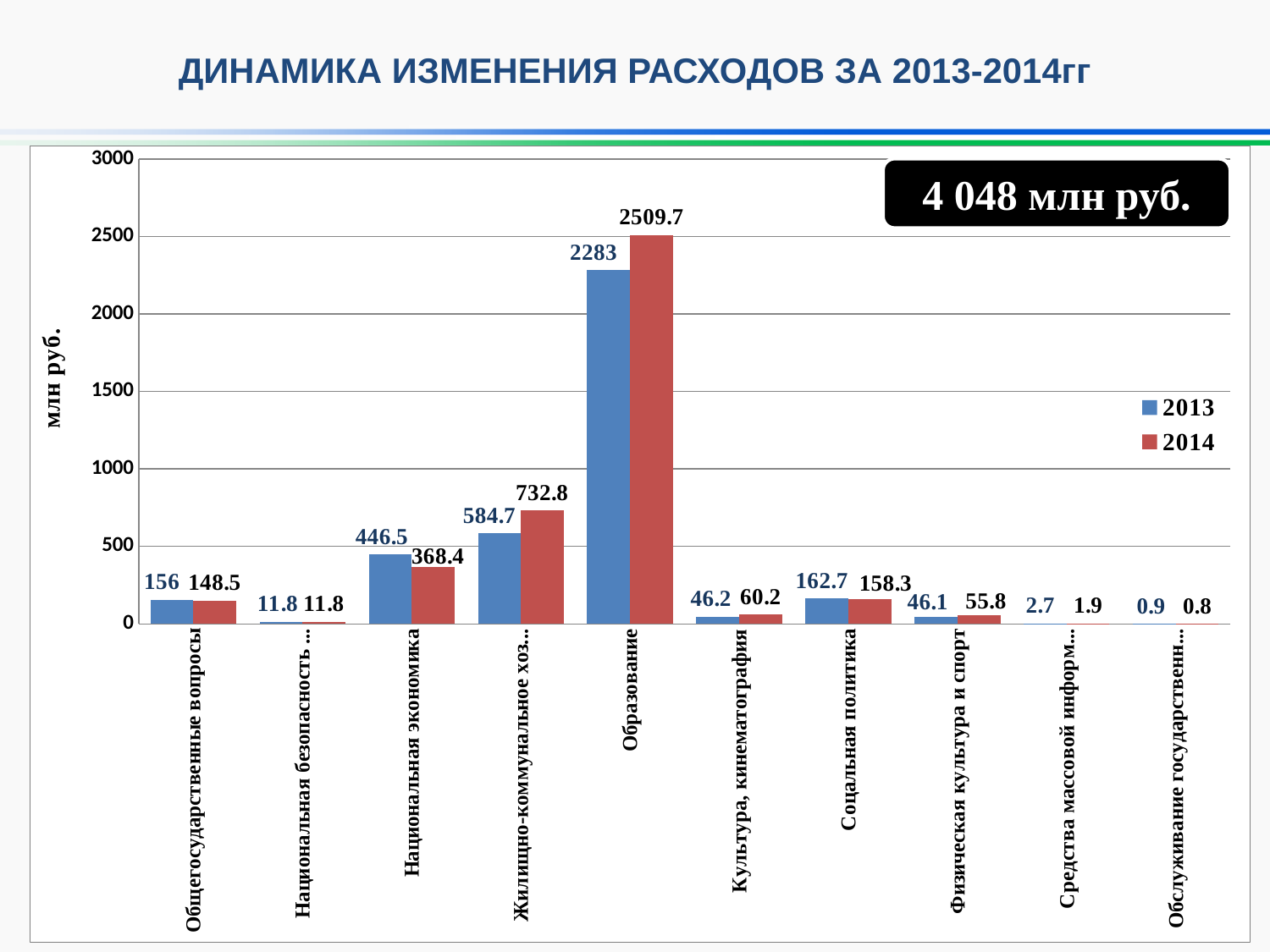
How many categories are shown on the x axis? 10 What kind of chart is shown on the slide? bar chart What is the 2014 value for Культура, кинематография? 60.2 Is the 2014 value for Жилищно-коммунальное хоз... greater or less than 500? greater Which category has the lowest 2014 value? Обслуживание государственн... What is the 2014 value for Образование? 2509.7 How many series does the legend list? 2 Which is larger for Национальная экономика: the 2013 value or the 2014 value? 2013 What is the difference between the 2014 and 2013 values for Образование? 226.7 What is the title of the slide? ДИНАМИКА ИЗМЕНЕНИЯ РАСХОДОВ ЗА 2013-2014гг Which category has the highest 2013 value? Образование What is the 2013 value for Национальная экономика? 446.5